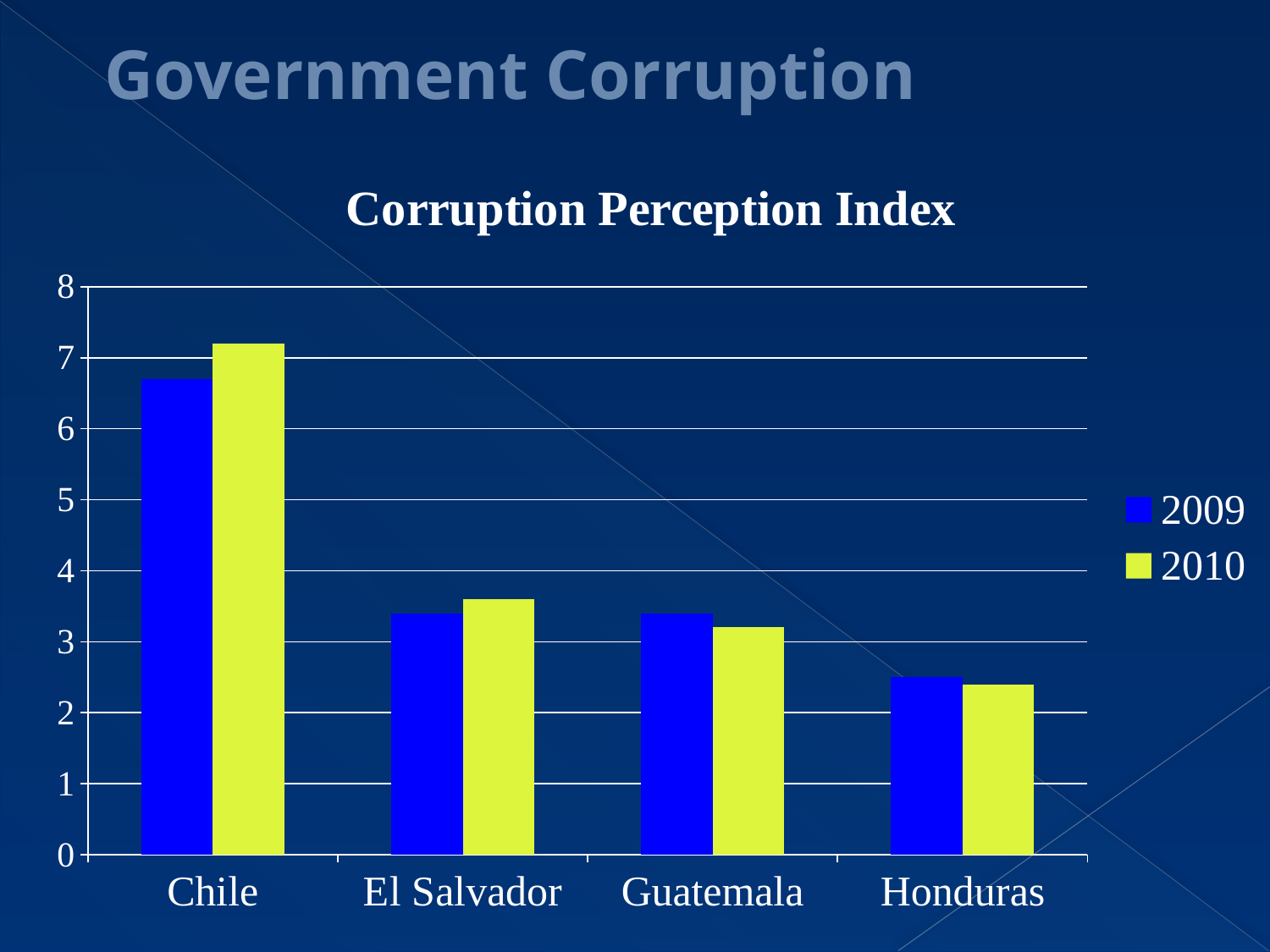
Which country has the lowest Corruption Perception Index in 2009? Honduras Which is larger, the 2009 value for Chile or the 2009 value for El Salvador? Chile Which country has the highest Corruption Perception Index in 2010? Chile For Chile, which year has the larger value, 2009 or 2010? 2010 Which colour represents the 2010 series in the legend? yellow What is the title of the chart? Corruption Perception Index How many countries are shown on the x axis? 4 What kind of chart is shown on the slide? bar chart Is the 2009 value for Chile greater or less than 6? greater How many series does the legend list? 2 Is the 2010 value for El Salvador greater or less than 3? greater Is the 2009 value for Honduras greater or less than 3? less